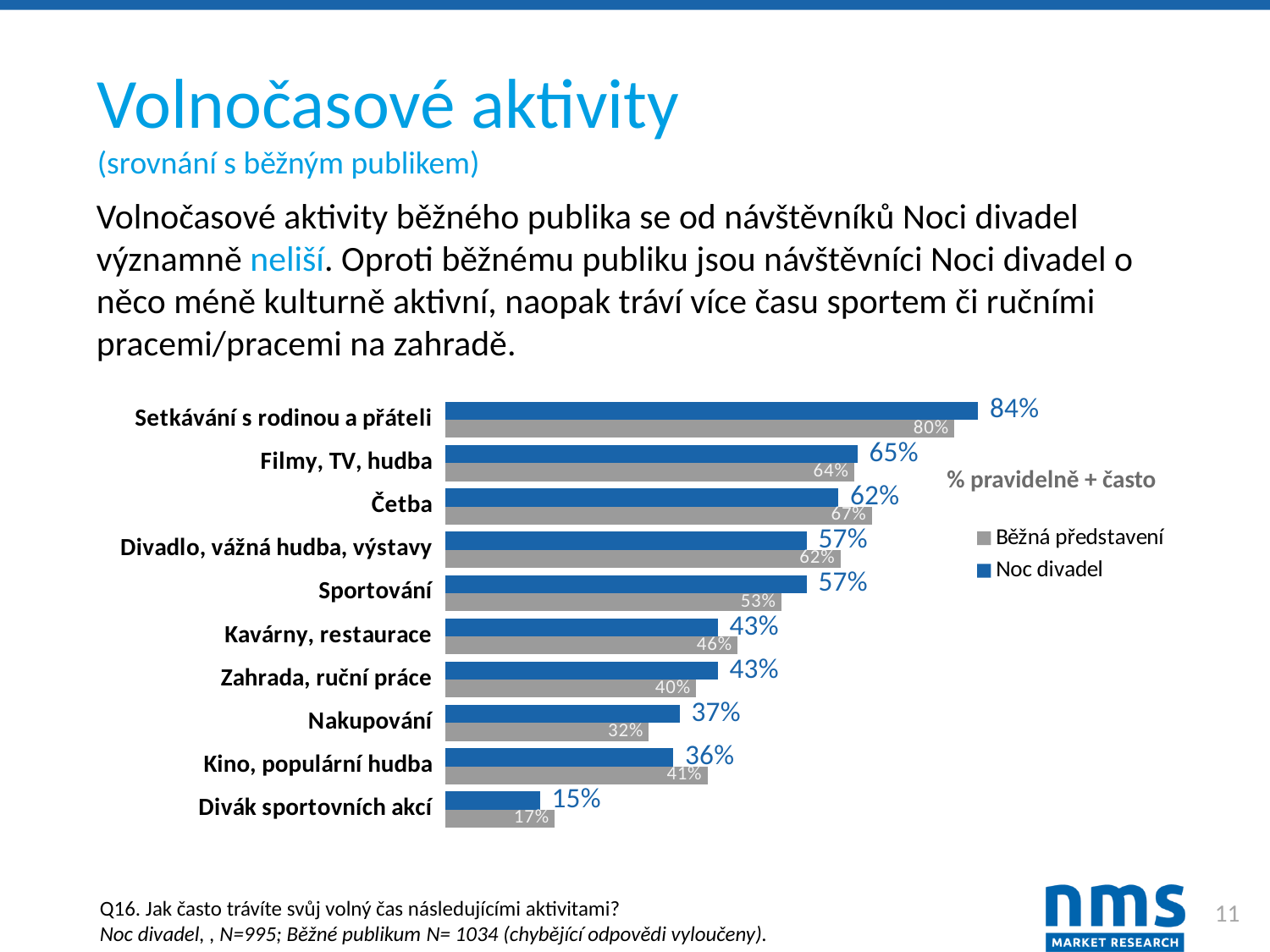
Which colour represents the Noc divadel series in the chart? Blue What is the Běžná představení value for Četba? 67% Which category has the lowest Běžná představení value? Divák sportovních akcí What is the Běžná představení value for Kino, populární hudba? 41% What is the Noc divadel value for Nakupování? 37% Which category has the highest Noc divadel value? Setkávání s rodinou a přáteli For Divadlo, vážná hudba, výstavy, which series has the larger value: Noc divadel or Běžná představení? Běžná představení How many series does the legend list? 2 What type of chart is shown on the slide? Bar chart What is the Noc divadel value for Setkávání s rodinou a přáteli? 84% How many activity categories are shown in the chart? 10 What is the difference between the Noc divadel and Běžná představení values for Nakupování? 5 percentage points